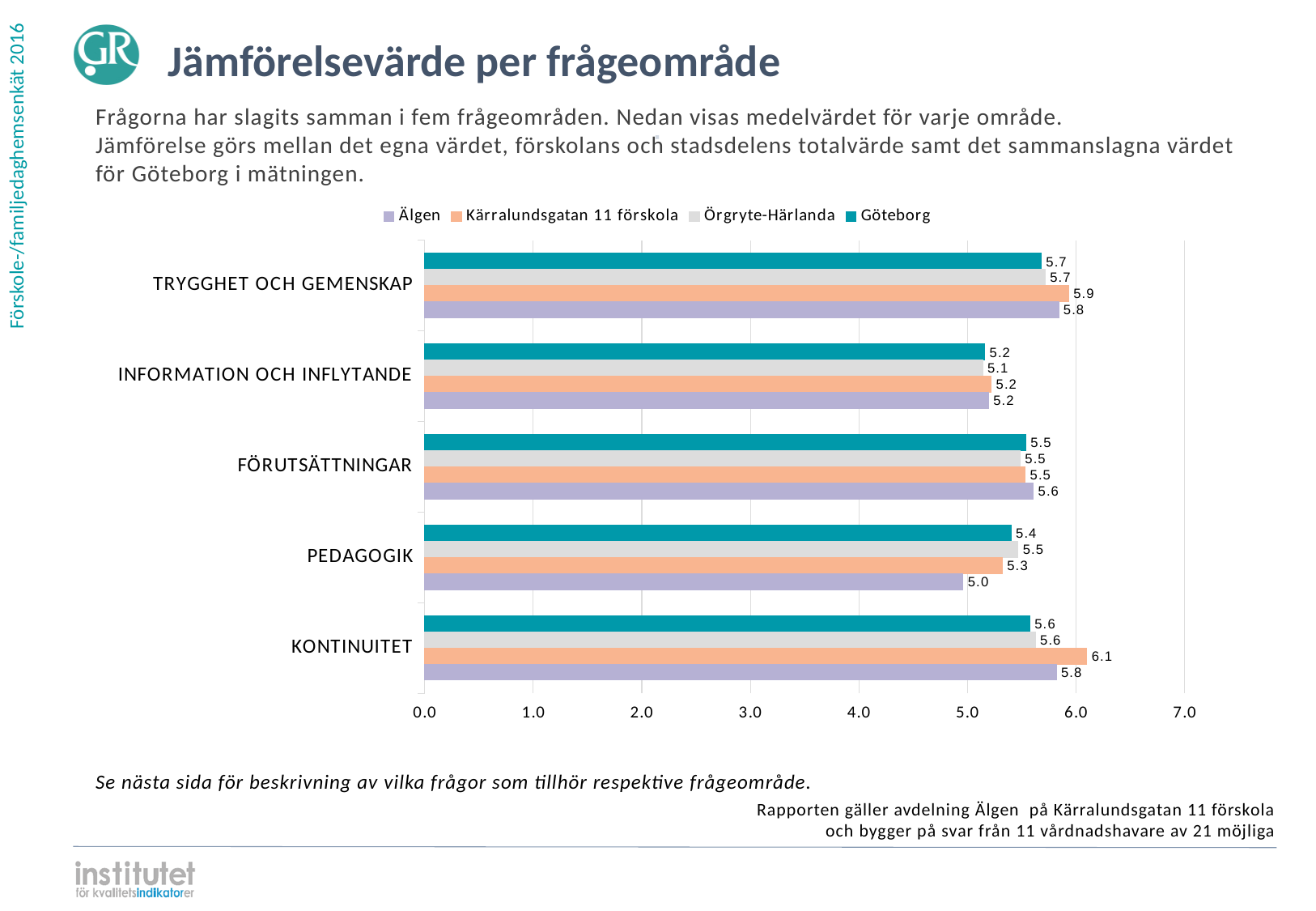
How many categories are shown on the chart? 5 What kind of chart is shown on the slide? Bar chart Which series is shown in orange in the legend? Kärralundsgatan 11 förskola How many series does the legend list? 4 What is the value for Örgryte-Härlanda in the INFORMATION OCH INFLYTANDE category? 5.1 What is the value for Kärralundsgatan 11 förskola in the KONTINUITET category? 6.1 In which category does Kärralundsgatan 11 förskola have its highest value? KONTINUITET In which category does Älgen have its lowest value? PEDAGOGIK What is the value for Göteborg in the TRYGGHET OCH GEMENSKAP category? 5.7 What is the difference between the Kärralundsgatan 11 förskola value and the Älgen value in the KONTINUITET category? 0.3 Which is larger in the PEDAGOGIK category: the value for Örgryte-Härlanda or the value for Älgen? Örgryte-Härlanda What is the value for Älgen in the PEDAGOGIK category? 5.0